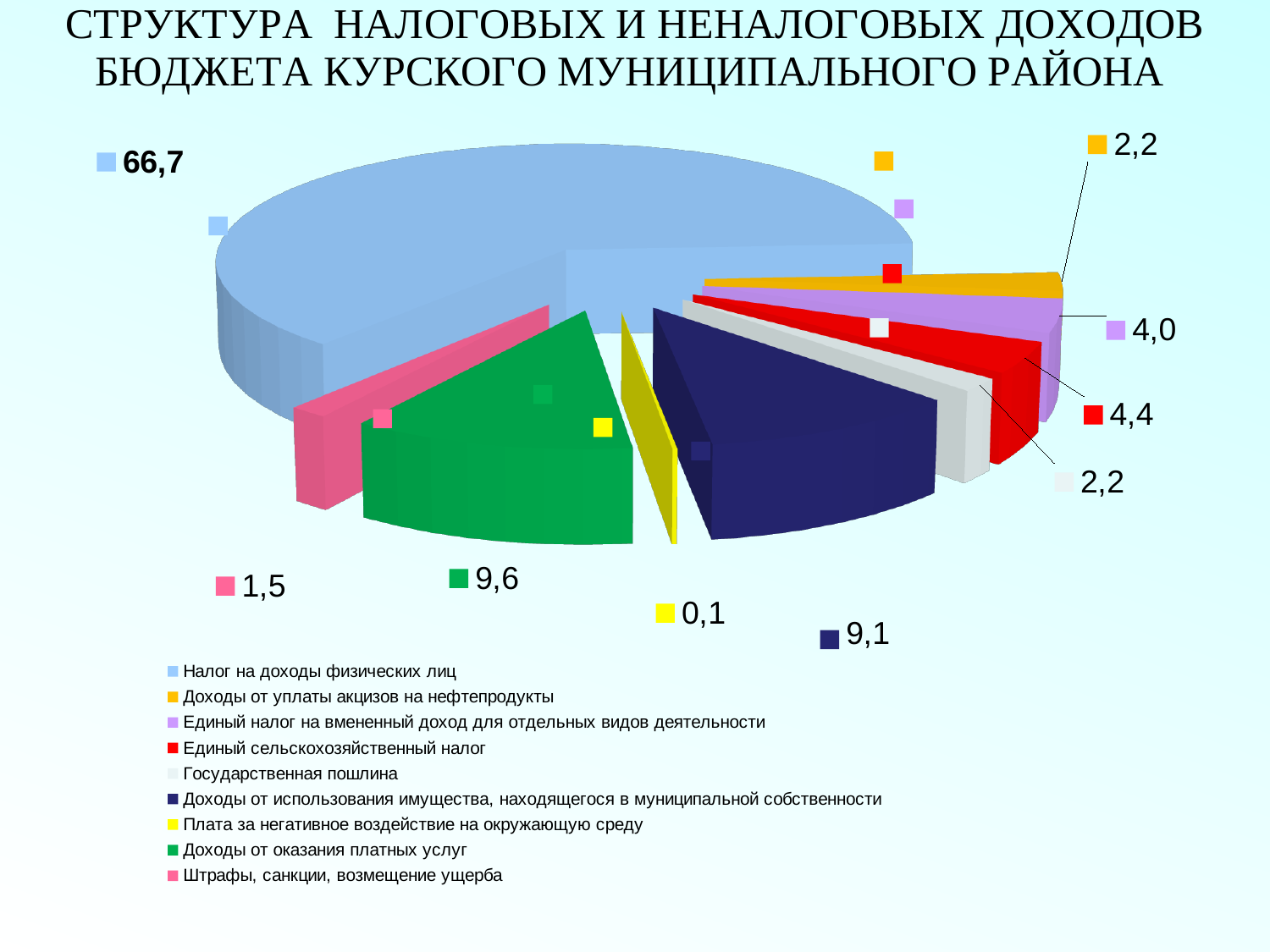
What is the value for "Единый сельскохозяйственный налог"? 4,4 What colour is the slice for "Штрафы, санкции, возмещение ущерба"? Pink What is the difference between the values for "Доходы от оказания платных услуг" and "Доходы от использования имущества, находящегося в муниципальной собственности"? 0,5 What is the value for "Налог на доходы физических лиц"? 66,7 Which is larger: the value for "Единый сельскохозяйственный налог" or the value for "Единый налог на вмененный доход для отдельных видов деятельности"? Единый сельскохозяйственный налог What kind of chart is shown on the slide? Pie chart Which category has the largest share of the pie? Налог на доходы физических лиц How many categories does the legend list? 9 Which category has the smallest share of the pie? Плата за негативное воздействие на окружающую среду What is the value for "Доходы от оказания платных услуг"? 9,6 What is the value for "Плата за негативное воздействие на окружающую среду"? 0,1 What is the value for "Доходы от использования имущества, находящегося в муниципальной собственности"? 9,1